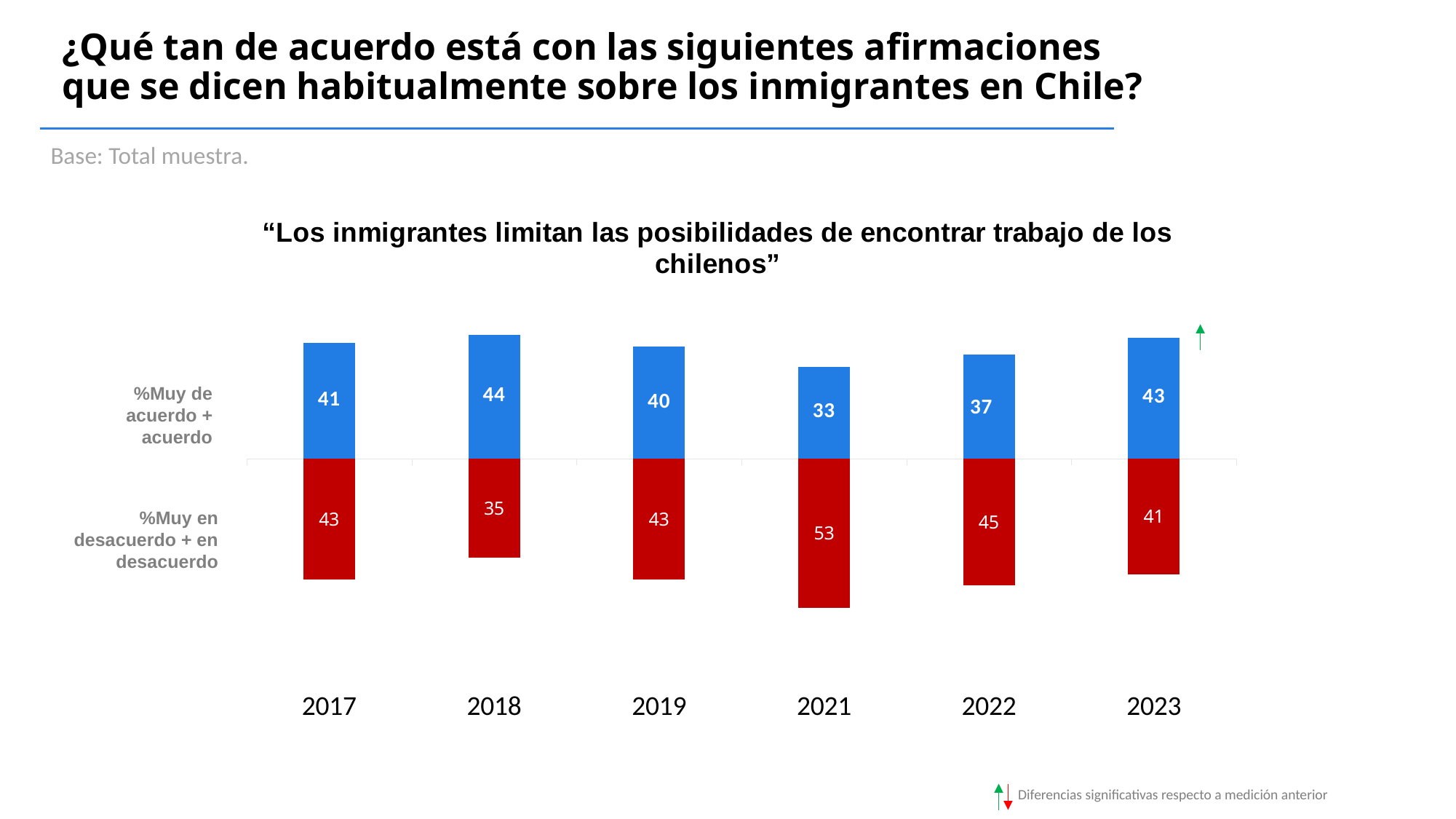
What is the value for "%Muy de acuerdo + acuerdo" in 2023? 43 What kind of chart is shown on the slide? Bar chart How many series does the chart show? 2 Which is larger in 2019: the "%Muy de acuerdo + acuerdo" value or the "%Muy en desacuerdo + en desacuerdo" value? %Muy en desacuerdo + en desacuerdo What is the value for "%Muy de acuerdo + acuerdo" in 2021? 33 How many years are shown on the x axis? 6 In which year is the "%Muy en desacuerdo + en desacuerdo" value highest? 2021 In which year is the "%Muy de acuerdo + acuerdo" value highest? 2018 What is the title of the chart? "Los inmigrantes limitan las posibilidades de encontrar trabajo de los chilenos" In which year is the "%Muy de acuerdo + acuerdo" value lowest? 2021 What is the value for "%Muy en desacuerdo + en desacuerdo" in 2018? 35 What is the difference between the "%Muy en desacuerdo + en desacuerdo" value in 2021 and in 2022? 8